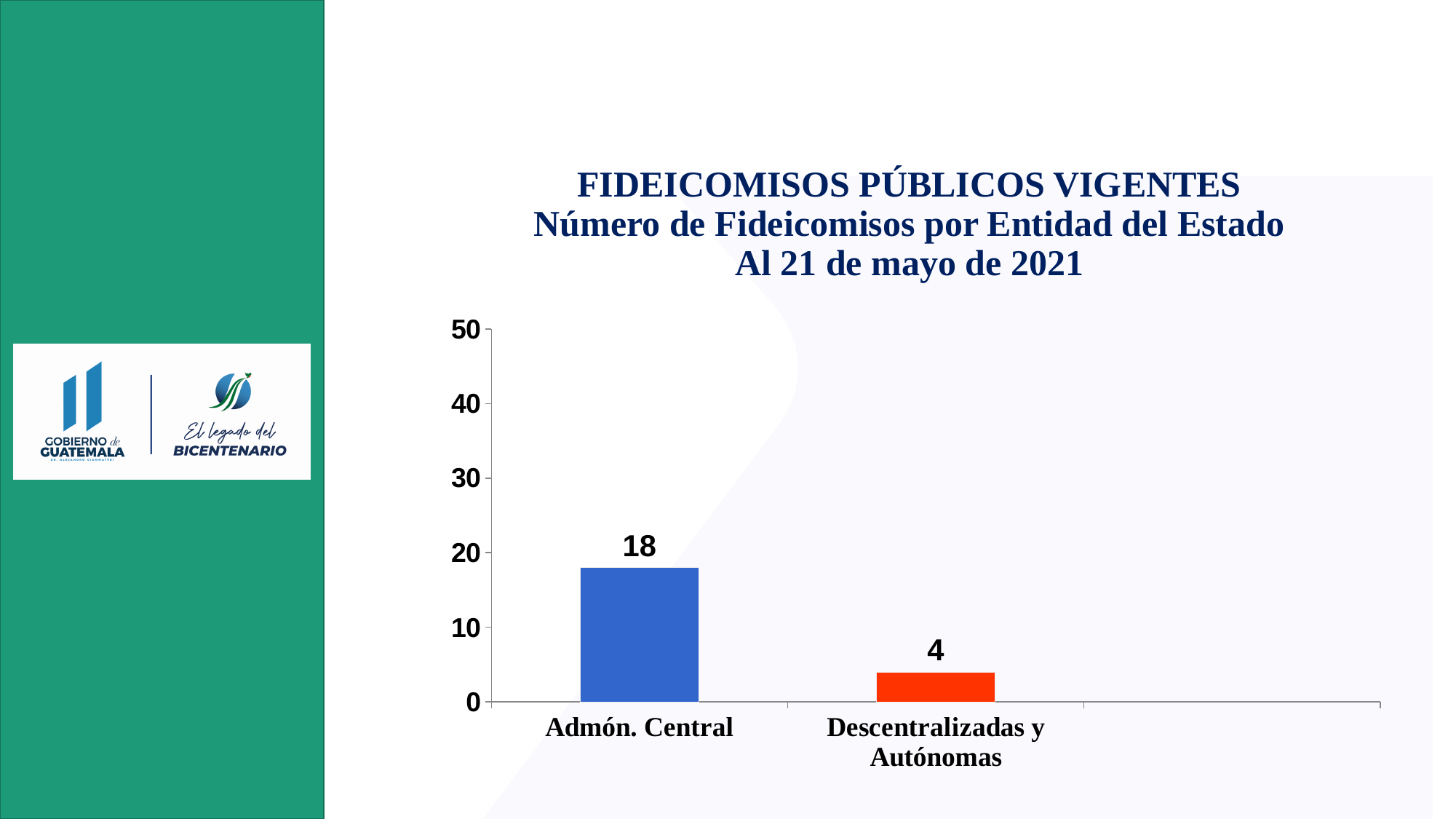
What date is given in the chart title? 21 de mayo de 2021 Which category has the lowest value? Descentralizadas y Autónomas What kind of chart is shown on the slide? Bar chart Is the value for Descentralizadas y Autónomas greater or less than 10? less Which is larger, the value for Admón. Central or the value for Descentralizadas y Autónomas? Admón. Central Which category has the highest value? Admón. Central What is the value for Admón. Central? 18 What is the difference between the values for Admón. Central and Descentralizadas y Autónomas? 14 What is the value for Descentralizadas y Autónomas? 4 Is the value for Admón. Central greater or less than 20? less How many categories are shown on the x axis? 2 What is the total of the two values shown in the chart? 22